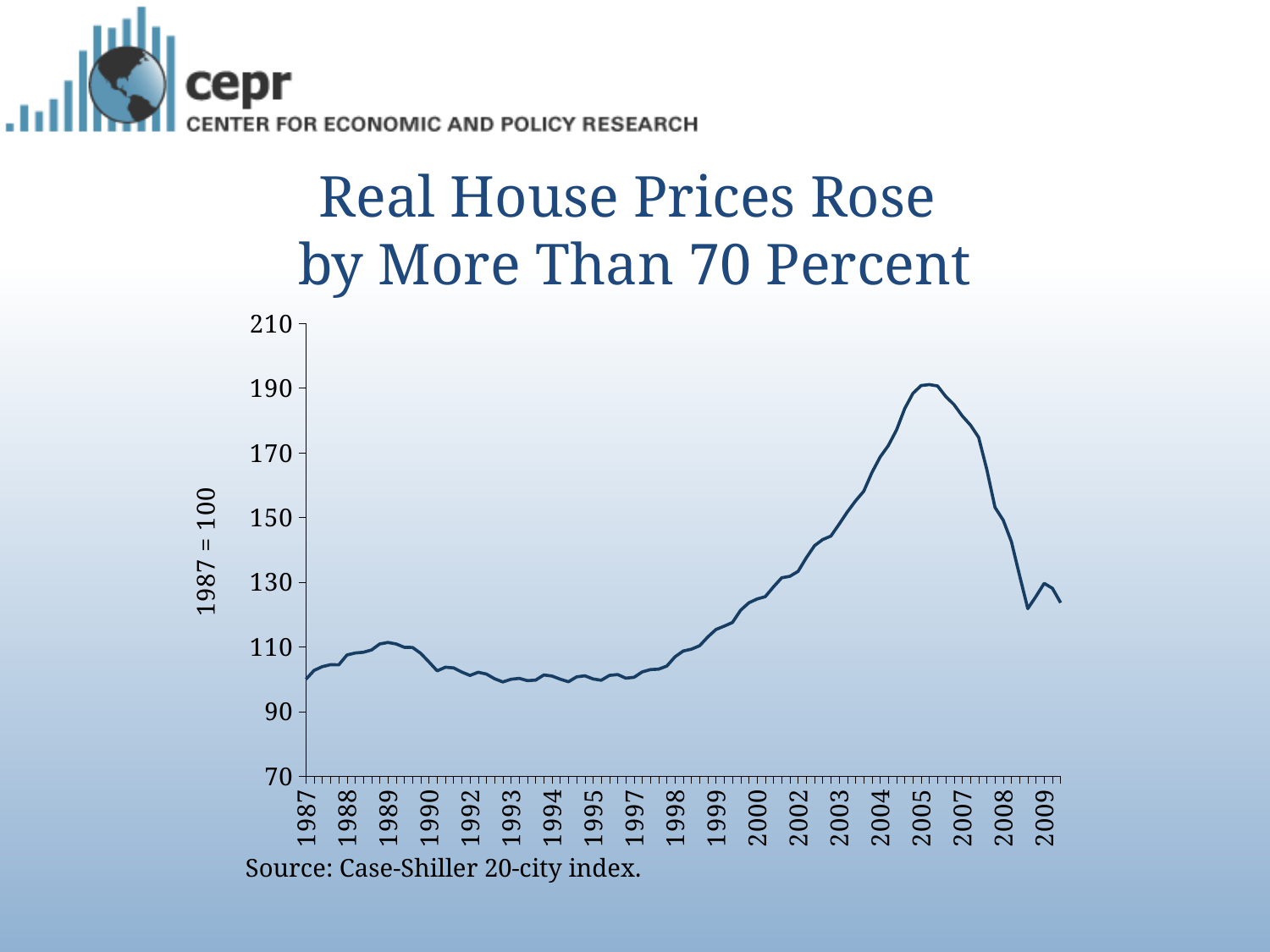
Does the index rise or fall between 1997 and 2005? rise Does the index rise or fall between 2006 and 2008? fall Is the peak value of the line greater or less than 170? greater What is the title of the chart on the slide? Real House Prices Rose by More Than 70 Percent What kind of chart is shown on the slide? line chart What is the label on the vertical axis of the chart? 1987 = 100 Is the value of the index in 1987 greater or less than 110? less Is the value of the index in 2003 greater or less than 130? greater How many lines (series) are plotted on the chart? 1 Which is larger, the index value in 2003 or the index value in 1990? 2003